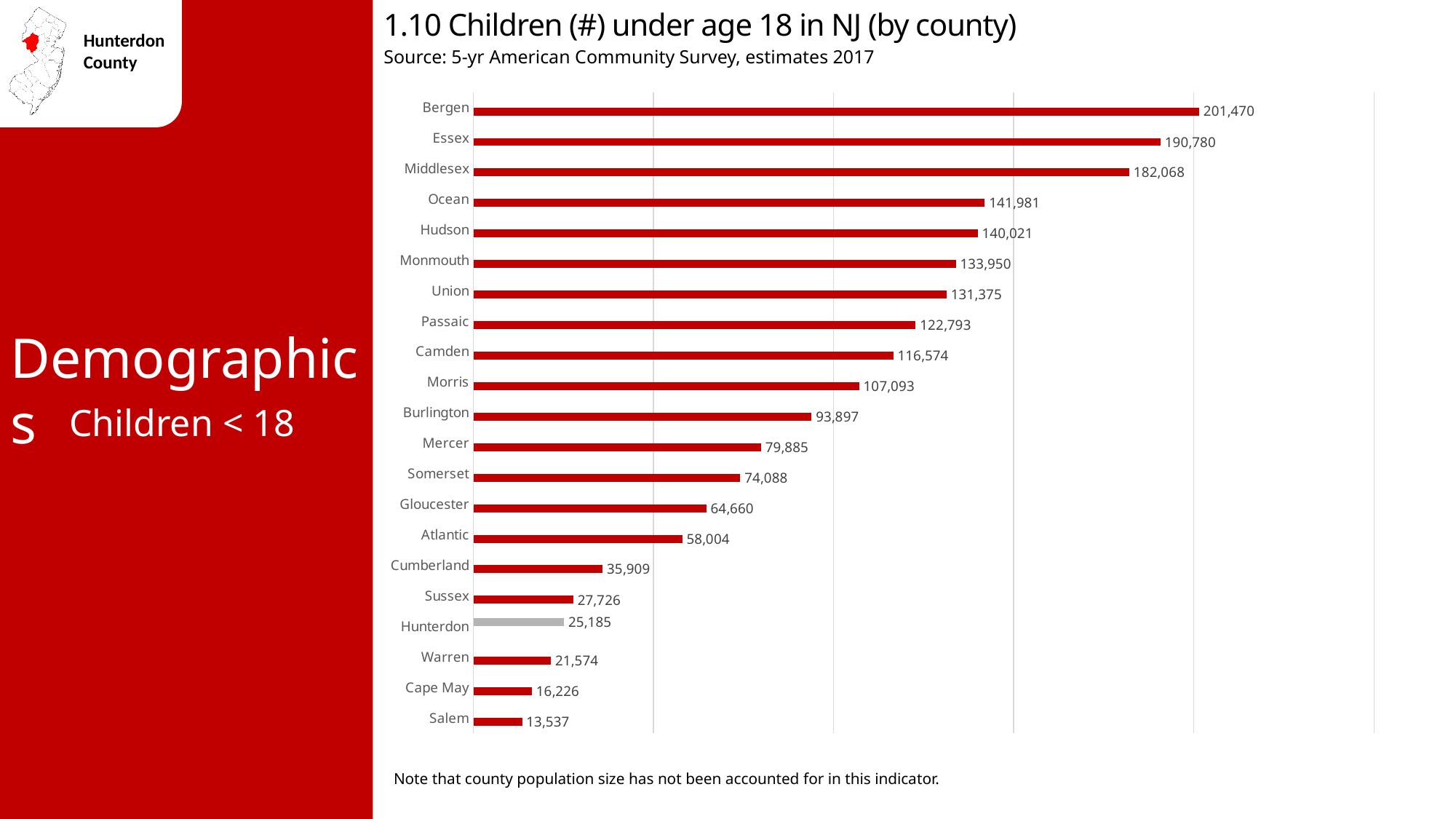
What is the value shown for Ocean County? 141,981 What type of chart is shown on the slide? Bar chart Which county's bar is coloured grey instead of red? Hunterdon Which county has the lowest number of children under age 18? Salem What is the difference between the values for Hunterdon and Warren? 3,611 What is the value shown for Cape May County? 16,226 Which county has more children under 18, Morris or Camden? Camden Which county has the highest number of children under age 18? Bergen How many children under age 18 does the chart show for Hunterdon County? 25,185 How many counties are shown in the chart? 21 Which county has more children under 18, Sussex or Hunterdon? Sussex What is the difference between the values for Bergen and Essex? 10,690